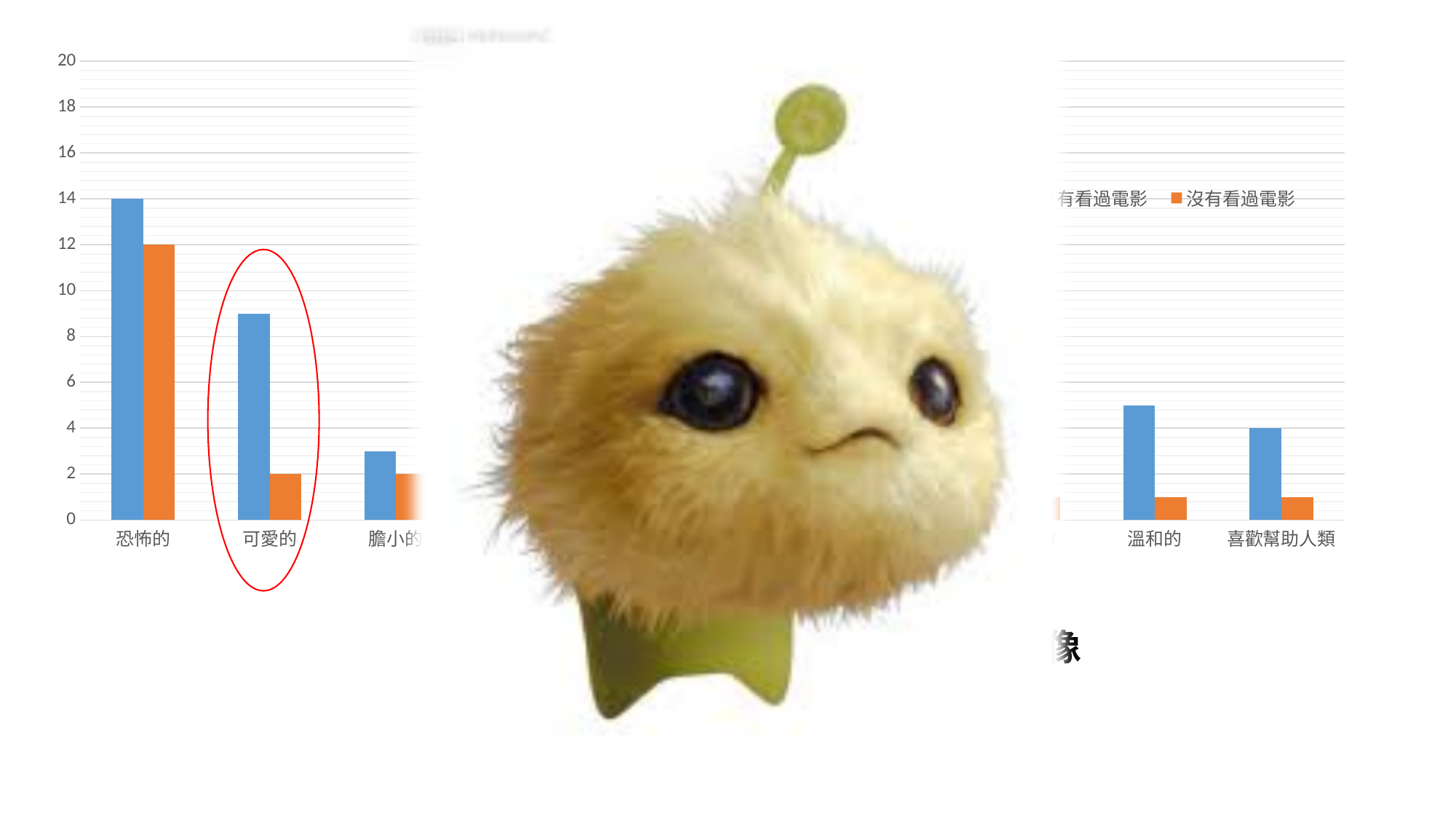
What kind of chart is shown on the slide? bar chart Which category on the chart is circled in red? 可愛的 How many series does the chart's legend list? 2 Is the value of the 沒有看過電影 bar for 溫和的 greater or less than 2? less What is the value of the blue bar for 恐怖的? 14 For 可愛的, which is larger: the blue bar or the 沒有看過電影 bar? the blue bar Is the value of the blue bar for 可愛的 greater or less than 8? greater What is the value of the 沒有看過電影 bar for 可愛的? 2 What is the difference between the blue bar and the 沒有看過電影 bar for 恐怖的? 2 Which visible category has the highest blue bar? 恐怖的 What is the value of the blue bar for 喜歡幫助人類? 4 What is the value of the 沒有看過電影 bar for 恐怖的? 12